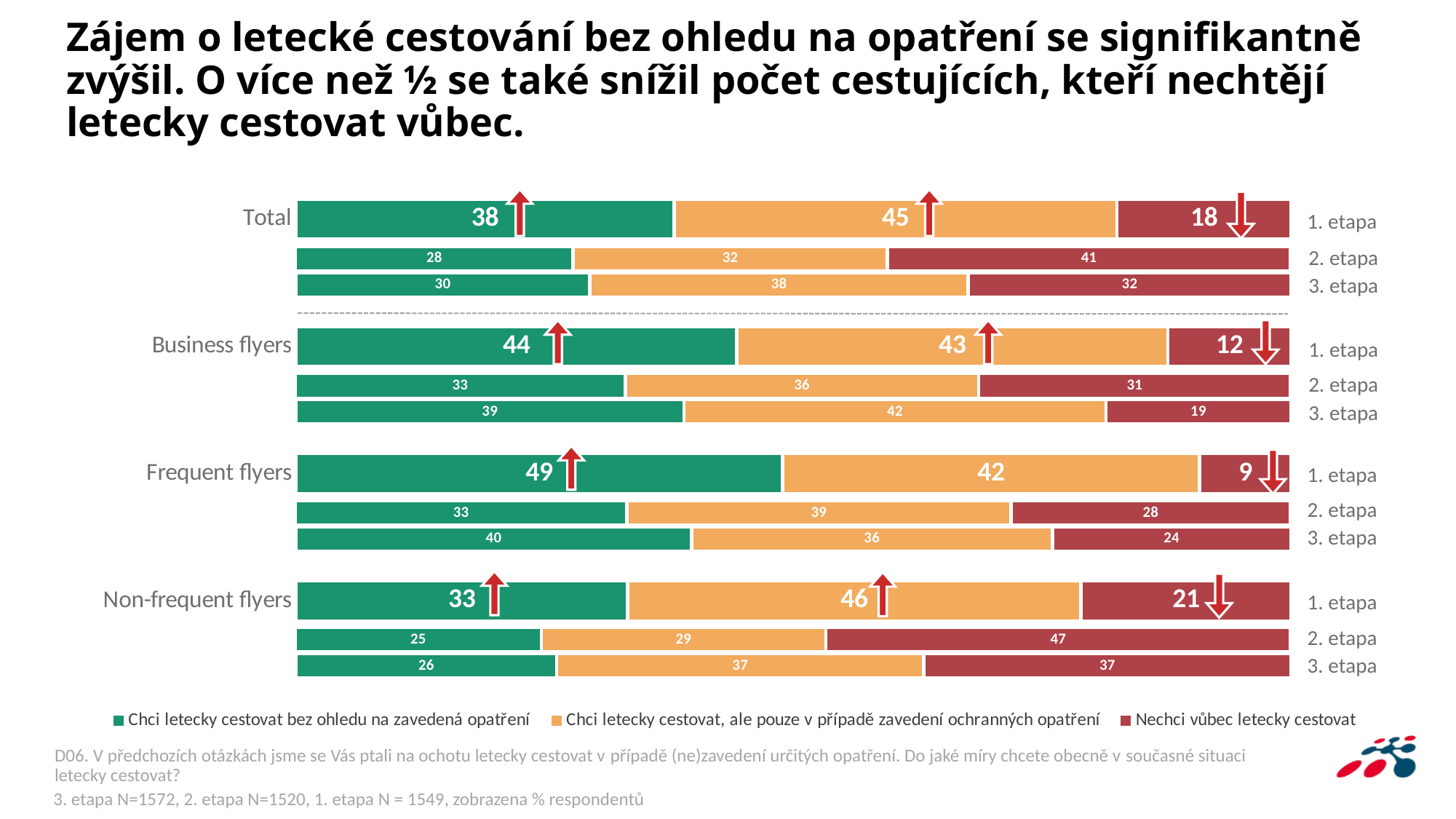
What kind of chart is shown on the slide? Stacked bar chart Which group has the highest value for "Chci letecky cestovat bez ohledu na zavedená opatření" in 1. etapa? Frequent flyers What is the value for "Nechci vůbec letecky cestovat" for Non-frequent flyers in 2. etapa? 47 What is the value for "Chci letecky cestovat bez ohledu na zavedená opatření" for Total in 1. etapa? 38 Which colour represents "Nechci vůbec letecky cestovat" in the chart? Red Which group has the lowest value for "Nechci vůbec letecky cestovat" in 1. etapa? Frequent flyers Which is larger for Non-frequent flyers in 1. etapa: "Chci letecky cestovat bez ohledu na zavedená opatření" or "Chci letecky cestovat, ale pouze v případě zavedení ochranných opatření"? Chci letecky cestovat, ale pouze v případě zavedení ochranných opatření What is the difference between the "Nechci vůbec letecky cestovat" values for Total in 2. etapa and 1. etapa? 23 What is the total of the stacked bar for Frequent flyers in 3. etapa? 100 How many respondent groups are shown on the chart? 4 How many series does the legend list? 3 What is the value for "Chci letecky cestovat, ale pouze v případě zavedení ochranných opatření" for Business flyers in 3. etapa? 42